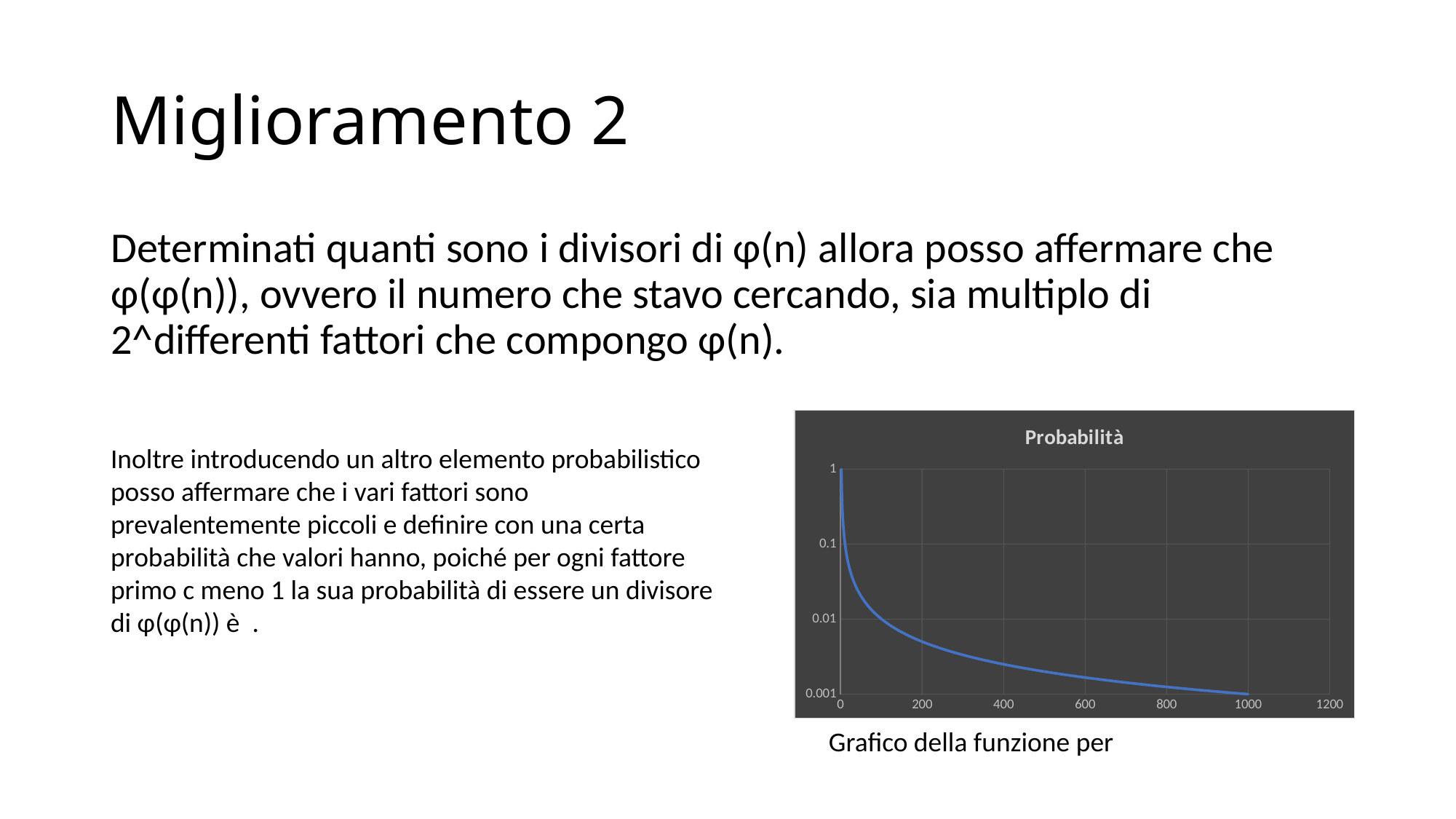
Is the value of the curve at x = 200 greater or less than 0.1? less What is the largest tick value shown on the x axis? 1200 What kind of chart is shown on the slide? line chart Is the value of the curve at x = 800 greater or less than 0.01? less What is the title of the chart? Probabilità Is the value of the curve at x = 400 greater or less than 0.01? less What is the highest value reached by the curve, at x = 0? 1 Do the values on the chart rise or fall as the x axis increases? fall At which end of the x axis does the curve reach its lowest value, near 0 or near 1000? near 1000